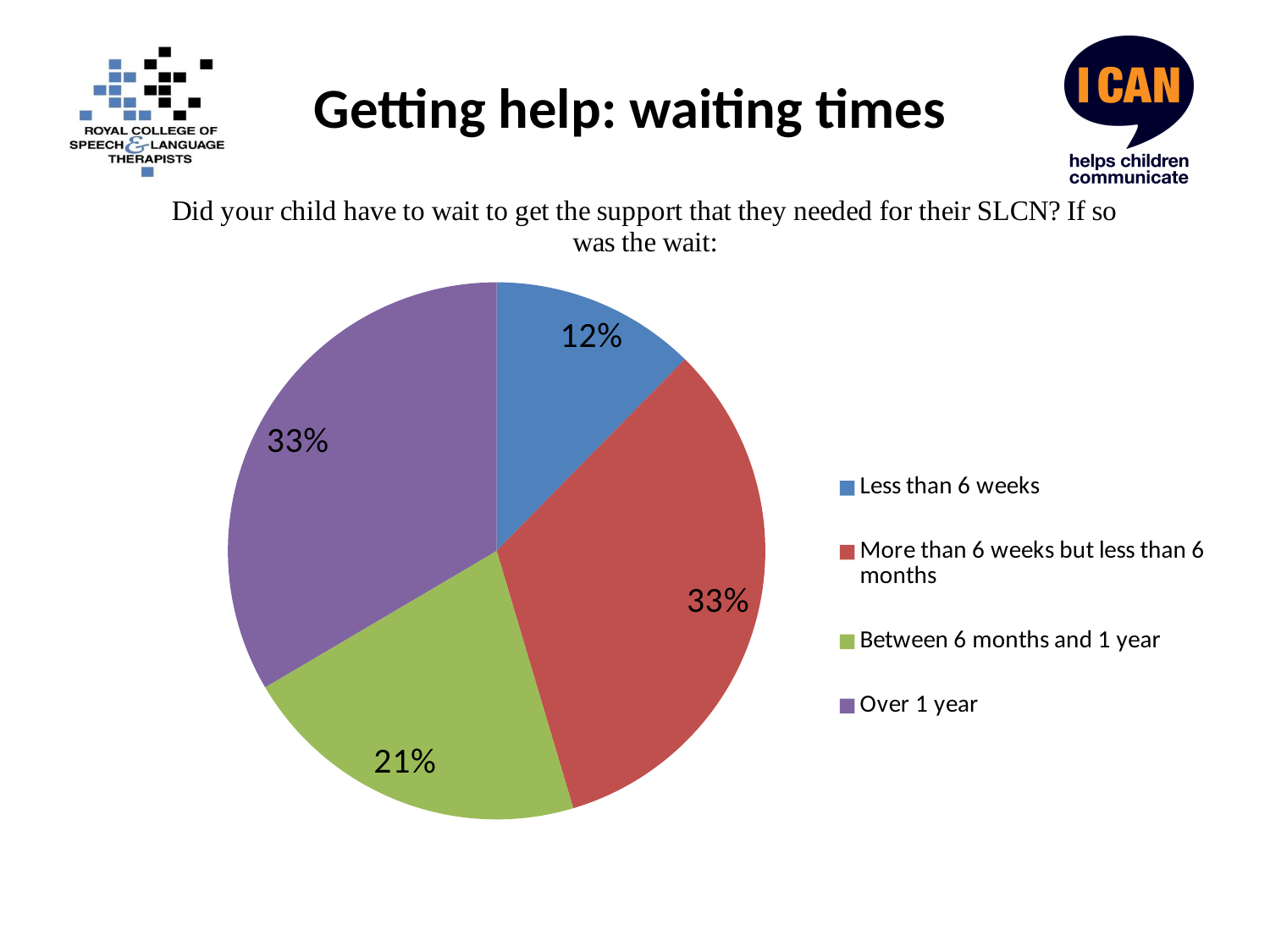
What share of the pie is labelled "Less than 6 weeks"? 12% What percentage is shown for "Over 1 year"? 33% What is the difference in percentage points between "Over 1 year" and "Less than 6 weeks"? 21 What is the difference in percentage points between "Between 6 months and 1 year" and "Less than 6 weeks"? 9 How many categories does the pie chart show? 4 Which is larger: the share for "Between 6 months and 1 year" or the share for "Less than 6 weeks"? Between 6 months and 1 year Which category has the smallest share of the pie? Less than 6 weeks What percentage of the pie is "Between 6 months and 1 year"? 21% What percentage is shown for "More than 6 weeks but less than 6 months"? 33% Which colour represents "Over 1 year" in the pie chart? Purple What type of chart is shown on the slide? Pie chart Which is larger: the share for "Over 1 year" or the share for "Between 6 months and 1 year"? Over 1 year